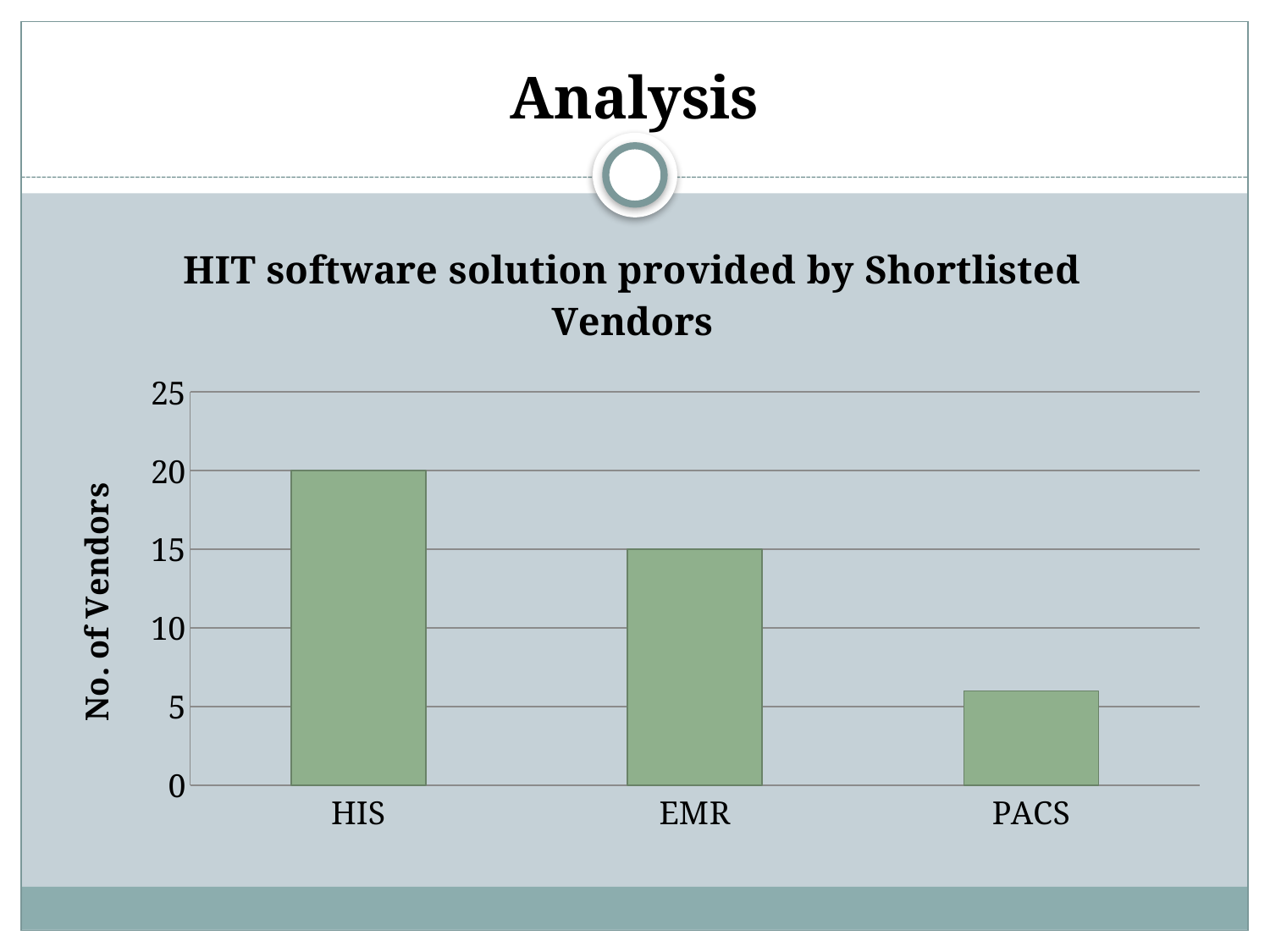
Is the value for PACS greater or less than 10? less Which category has the highest number of vendors? HIS What is the title of the chart? HIT software solution provided by Shortlisted Vendors Which is larger, the value for EMR or the value for PACS? EMR Which category has the lowest number of vendors? PACS What kind of chart is shown on the slide? bar chart What is the difference between the values for HIS and EMR? 5 What is the value for EMR? 15 Is the value for PACS greater or less than 5? greater Do the values rise or fall from HIS to PACS along the x axis? fall How many categories are shown on the x axis? 3 What is the value for HIS? 20